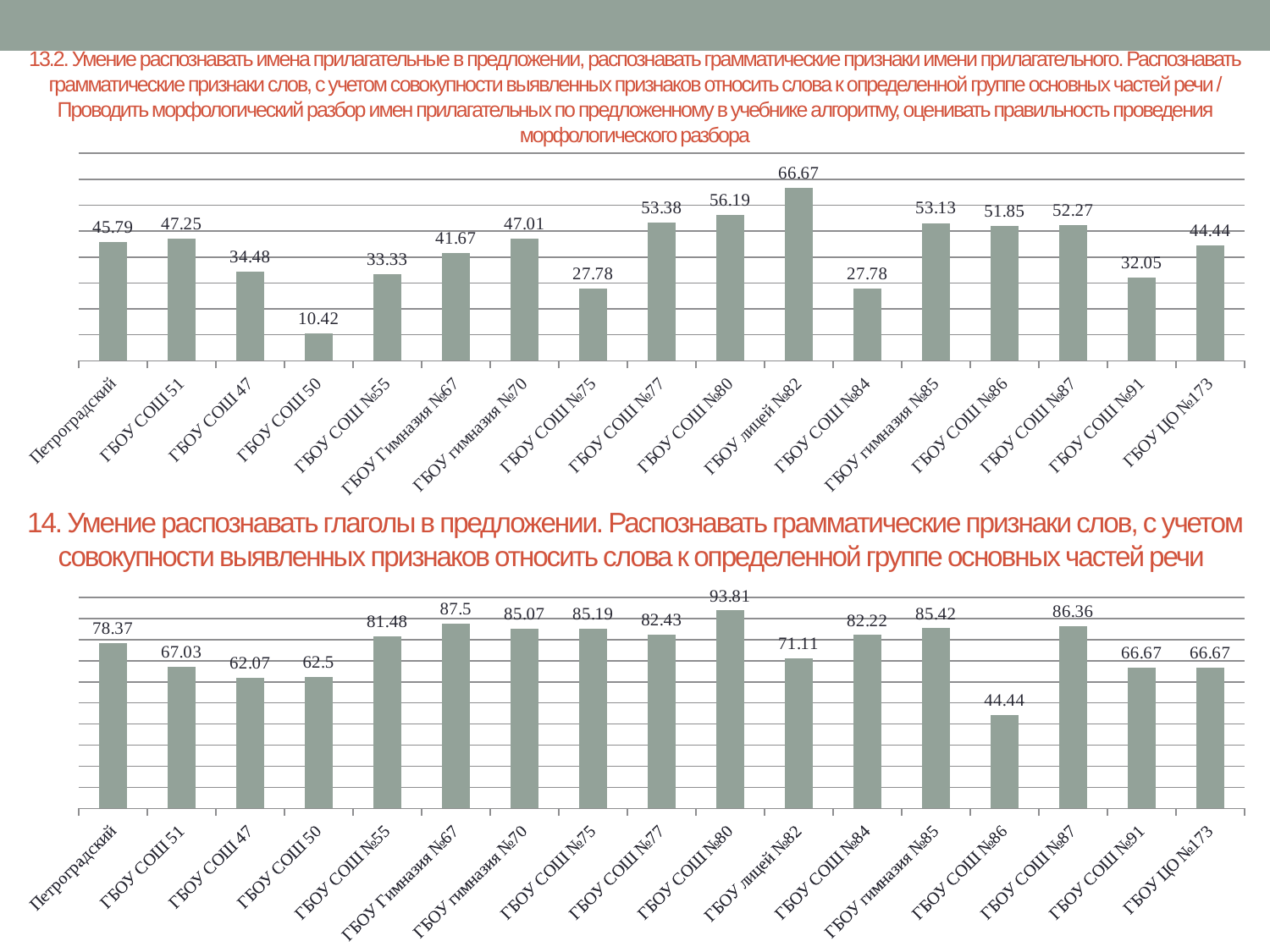
In the top chart (13.2), which school has the lowest value? ГБОУ СОШ 50 In the top chart (13.2), what is the value for ГБОУ лицей №82? 66.67 In the bottom chart (14), what is the value for ГБОУ СОШ №80? 93.81 In the bottom chart (14), which school has the lowest value? ГБОУ СОШ №86 In the top chart (13.2), how many schools are shown on the x axis? 17 In the bottom chart (14), what is the value for ГБОУ ЦО №173? 66.67 In the top chart (13.2), what is the difference between the values for ГБОУ СОШ №80 and ГБОУ СОШ №75? 28.41 What type of chart is the bottom chart (14)? Bar chart In the bottom chart (14), what is the difference between the values for Петроградский and ГБОУ СОШ 47? 16.3 In the bottom chart (14), which is larger: the value for ГБОУ Гимназия №67 or the value for ГБОУ СОШ №87? ГБОУ Гимназия №67 In the top chart (13.2), what is the value for ГБОУ СОШ №91? 32.05 In the top chart (13.2), which school has the highest value? ГБОУ лицей №82